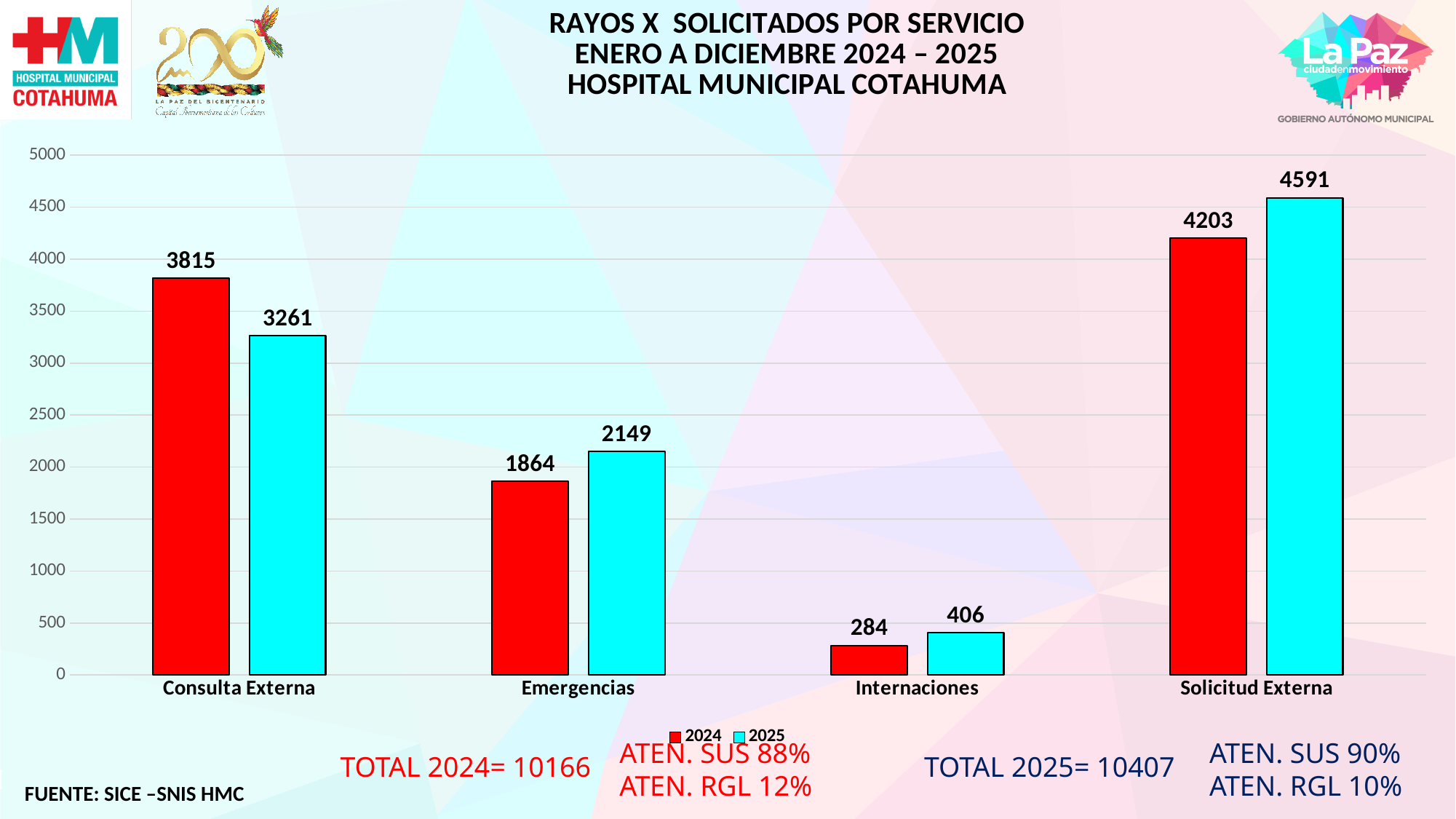
Which category has the highest value in 2025? Solicitud Externa What kind of chart is shown on the slide? Bar chart Which is larger for Internaciones, the 2024 value or the 2025 value? 2025 What is the value for Solicitud Externa in 2025? 4591 Which colour represents the 2025 series? Cyan Which category has the lowest value in 2024? Internaciones What is the difference between the 2025 and 2024 values for Emergencias? 285 How many series does the legend list? 2 What is the value for Consulta Externa in 2024? 3815 What is the difference between the 2024 and 2025 values for Consulta Externa? 554 What is the value for Internaciones in 2024? 284 How many categories are shown on the x axis? 4